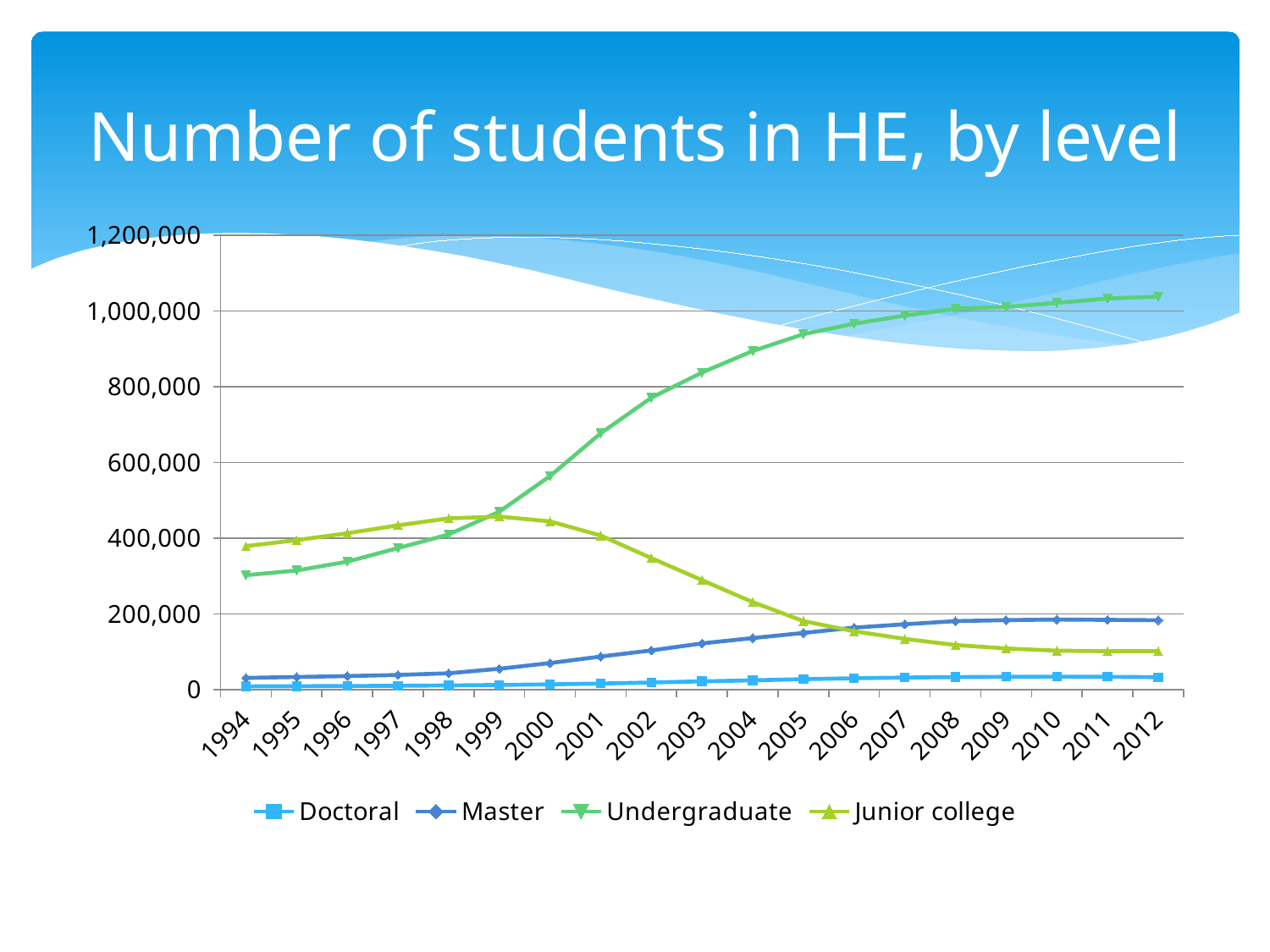
Is the value for Undergraduate in 1994 greater or less than 400,000? less Which series has the highest value in 2012? Undergraduate Is the value for Undergraduate in 2012 greater or less than 1,000,000? greater Does the Junior college series rise or fall from 2000 to 2012? Fall How many series does the legend list? 4 Is the value for Junior college in 2012 greater or less than 200,000? less In 1994, which is larger: Junior college or Undergraduate? Junior college Which series has the lowest value in 2012? Doctoral How many years are plotted along the x axis? 19 What is the title of the chart? Number of students in HE, by level What kind of chart is shown on the slide? Line chart Does the Undergraduate series rise or fall from 1994 to 2012? Rise